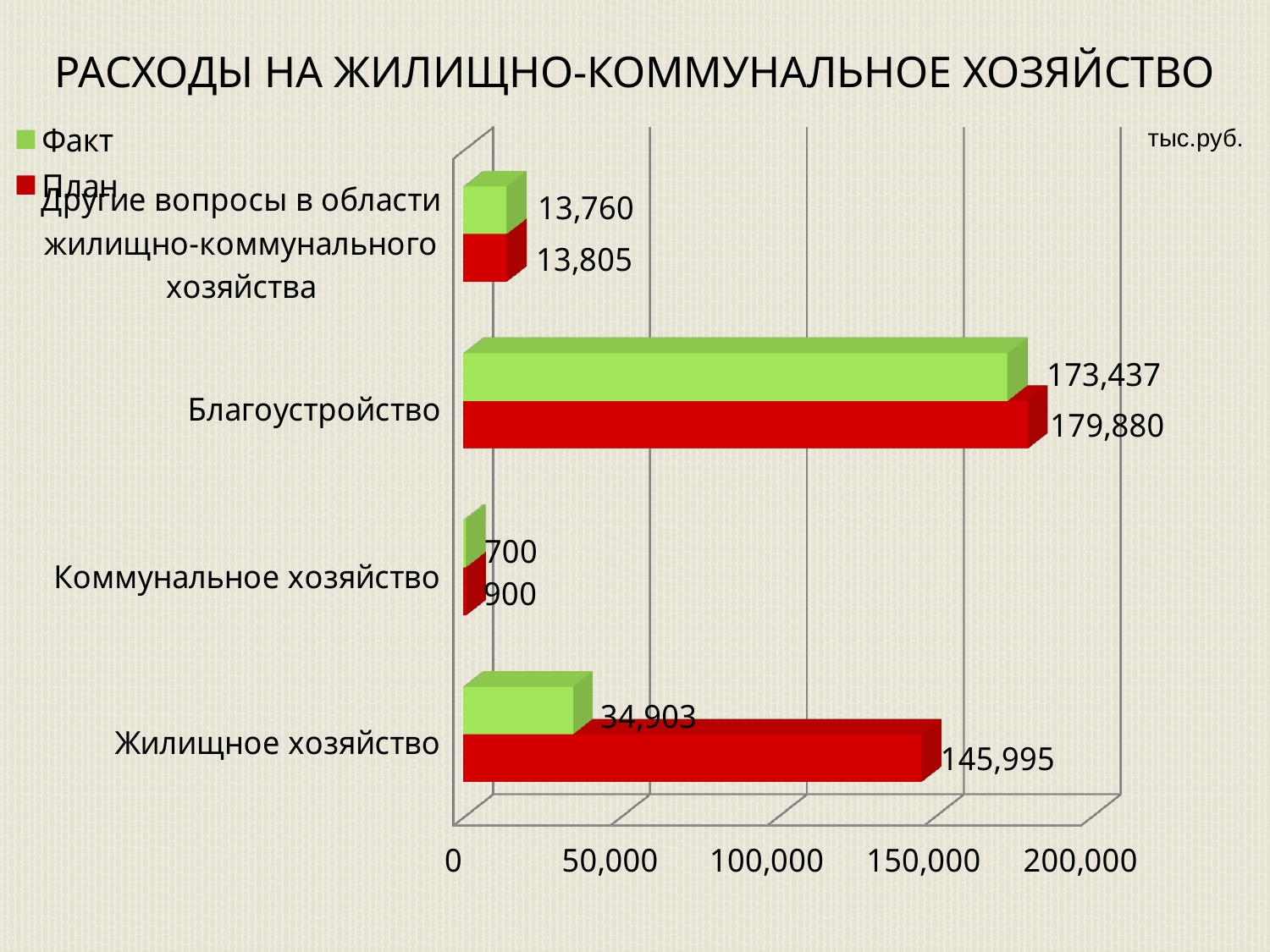
Which is larger for Коммунальное хозяйство, the Факт value or the План value? План What is the difference between the План and Факт values for Жилищное хозяйство? 111,092 What kind of chart is shown on the slide? Bar chart What is the difference between the План and Факт values for Благоустройство? 6,443 How many series does the legend list? 2 Which category has the highest План value? Благоустройство What is the План value for Жилищное хозяйство? 145,995 Which category has the lowest Факт value? Коммунальное хозяйство What is the Факт value for Коммунальное хозяйство? 700 How many categories are shown on the chart? 4 What is the План value for Другие вопросы в области жилищно-коммунального хозяйства? 13,805 What is the Факт value for Благоустройство? 173,437